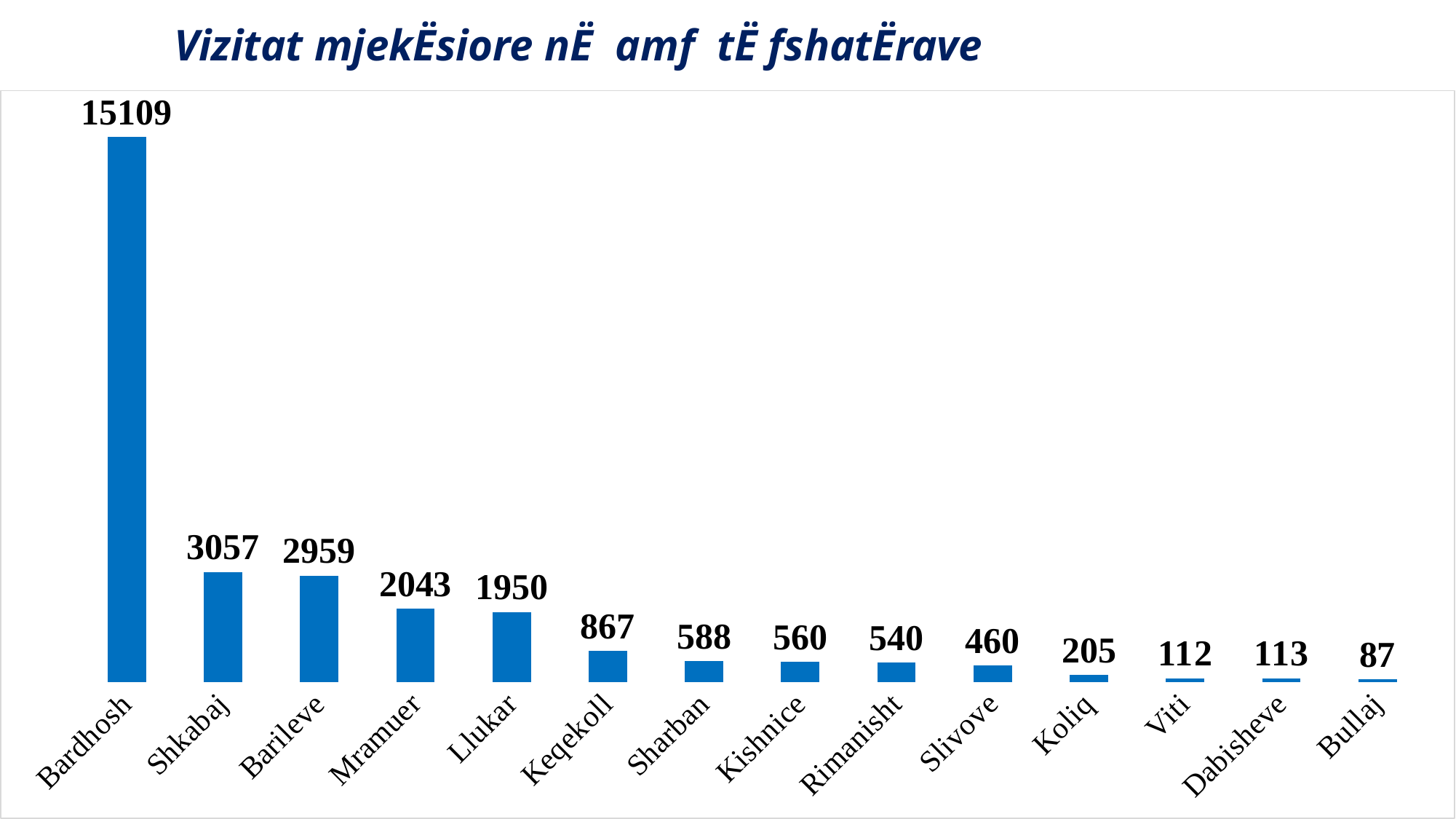
What is the difference between the values for Shkabaj and Barileve? 98 What is the difference between the values for Mramuer and Llukar? 93 What is the value for Llukar? 1950 Which category has the lowest value? Bullaj What is the value for Koliq? 205 What is the title of the chart? Vizitat mjekËsiore nË amf tË fshatËrave What is the value for Bardhosh? 15109 What kind of chart is shown on the slide? Bar chart Which is larger, the value for Keqekoll or the value for Sharban? Keqekoll Which category has the highest value? Bardhosh How many categories are shown on the x axis? 14 Which is larger, the value for Viti or the value for Dabisheve? Dabisheve